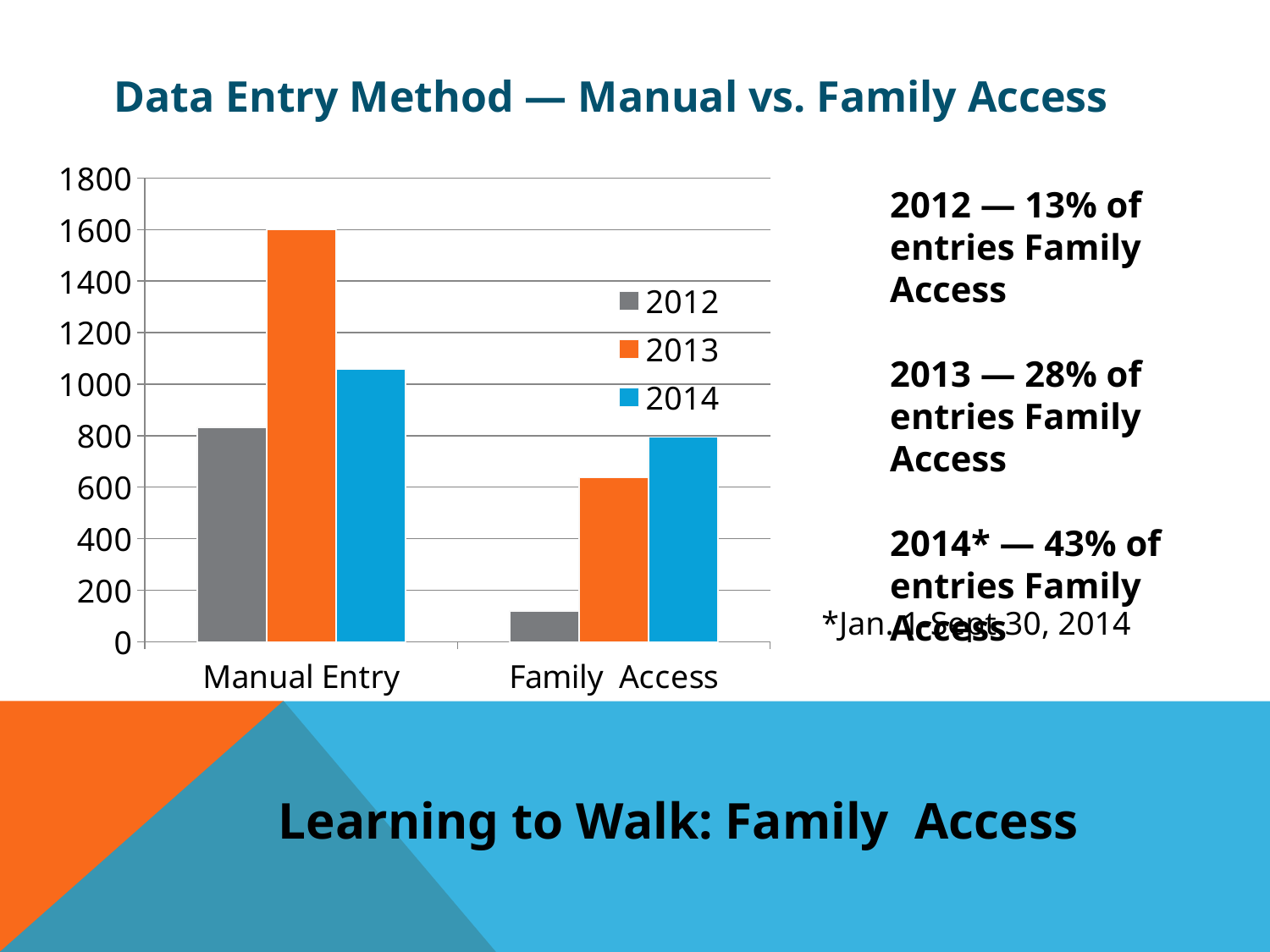
Which year has the lowest value for Manual Entry? 2012 How many series does the chart's legend list? 3 Is the value for Family Access in 2012 greater or less than 200? less What kind of chart is shown on the slide? bar chart Is the value for Family Access in 2014 greater or less than 600? greater What colour represents the 2013 series in the chart? orange Which year has the lowest value for Family Access? 2012 Do the Family Access values rise or fall from 2012 to 2014? rise Which is larger, the 2014 value for Manual Entry or the 2014 value for Family Access? Manual Entry How many categories are shown on the x axis of the chart? 2 Is the value for Manual Entry in 2013 greater or less than 1400? greater Which year has the highest value for Manual Entry? 2013